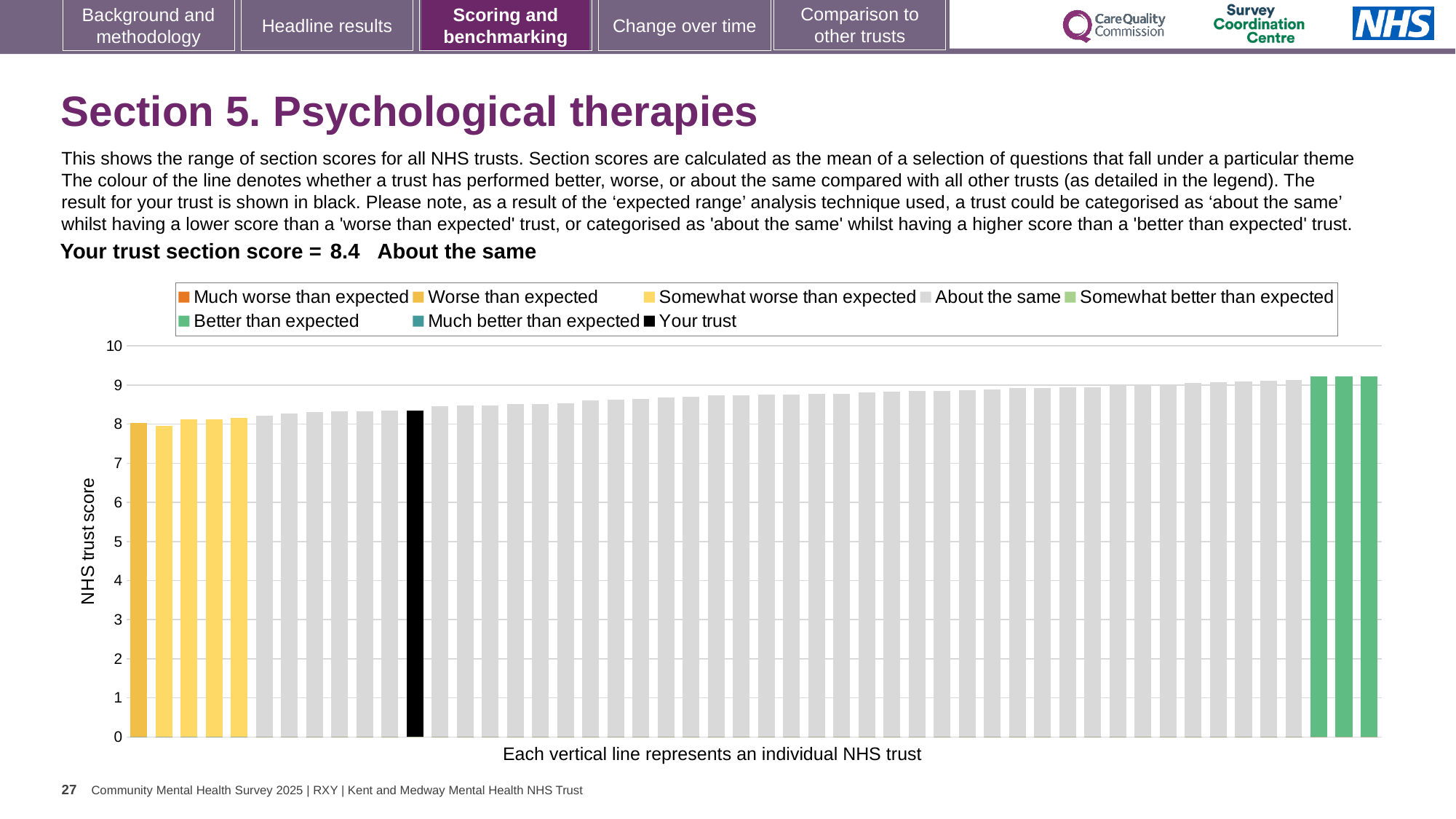
What is the section score for your trust shown on the slide? 8.4 Do the bar values rise or fall from left to right along the x axis? rise Is the value for your trust (the black bar) greater or less than 9? less Is the value of the leftmost bar greater or less than 9? less What is the label on the y axis of the chart? NHS trust score What kind of chart is shown on the slide? bar chart How many bars are coloured green (Better than expected)? 3 How many entries does the chart legend list? 8 Which category is your trust placed in for this section? About the same Is the value for your trust (the black bar) greater or less than 8? greater